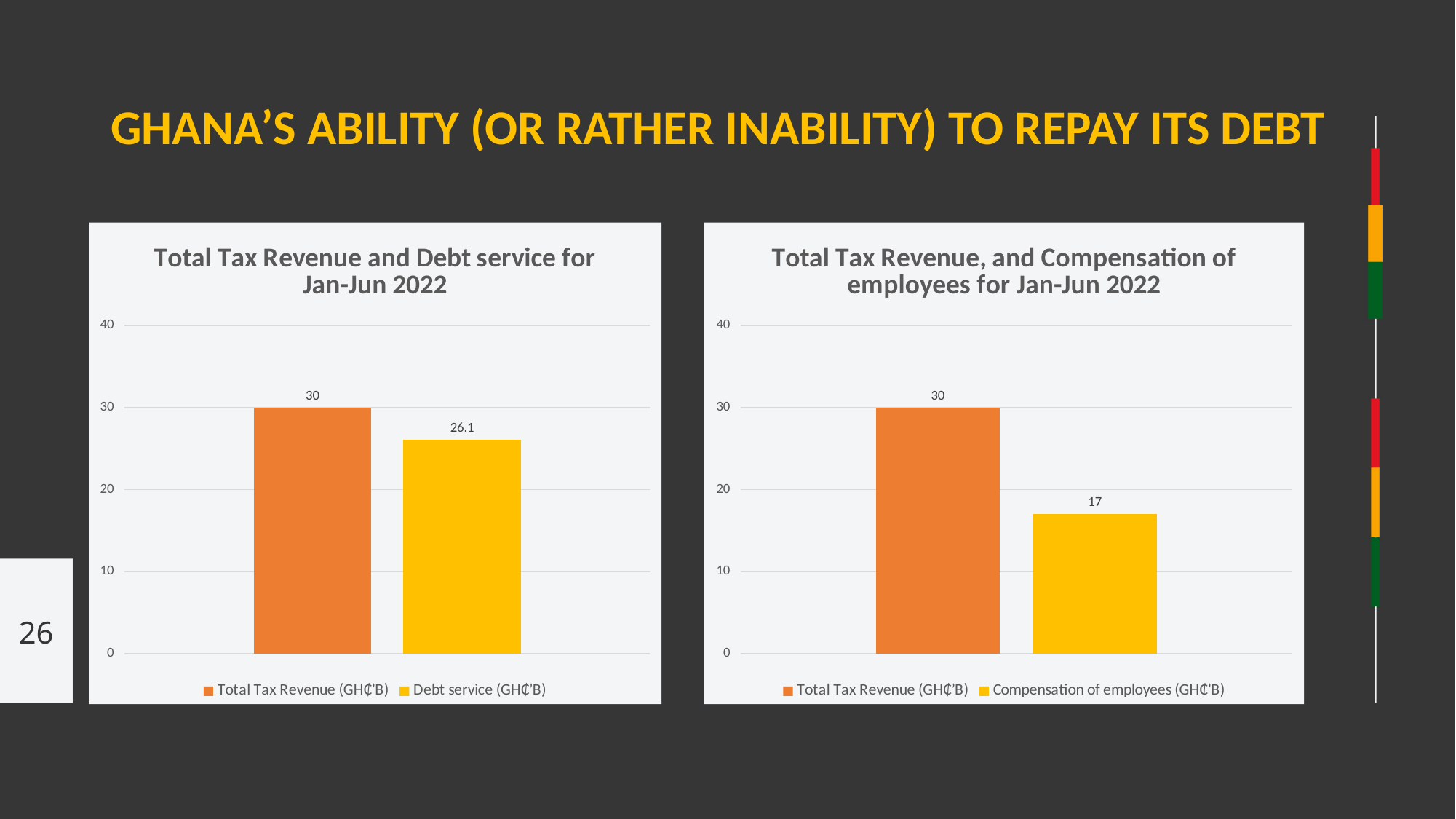
In the left chart (Total Tax Revenue and Debt service for Jan-Jun 2022), which series has the lowest value? Debt service (GH₵'B) In the right chart (Total Tax Revenue, and Compensation of employees for Jan-Jun 2022), which is larger: Total Tax Revenue or Compensation of employees? Total Tax Revenue In the left chart (Total Tax Revenue and Debt service for Jan-Jun 2022), is the value for Debt service greater or less than 20? greater In the right chart (Total Tax Revenue, and Compensation of employees for Jan-Jun 2022), which series has the highest value? Total Tax Revenue (GH₵'B) In the left chart (Total Tax Revenue and Debt service for Jan-Jun 2022), what is the value for Total Tax Revenue (GH₵'B)? 30 How many series does the legend of the right chart (Total Tax Revenue, and Compensation of employees for Jan-Jun 2022) list? 2 In the right chart (Total Tax Revenue, and Compensation of employees for Jan-Jun 2022), what colour is the Compensation of employees bar? Yellow In the left chart (Total Tax Revenue and Debt service for Jan-Jun 2022), what is the difference between Total Tax Revenue and Debt service? 3.9 In the right chart (Total Tax Revenue, and Compensation of employees for Jan-Jun 2022), what is the value for Compensation of employees (GH₵'B)? 17 In the left chart (Total Tax Revenue and Debt service for Jan-Jun 2022), what is the value for Debt service (GH₵'B)? 26.1 What kind of chart is the left chart (Total Tax Revenue and Debt service for Jan-Jun 2022)? Bar chart In the right chart (Total Tax Revenue, and Compensation of employees for Jan-Jun 2022), what is the difference between Total Tax Revenue and Compensation of employees? 13